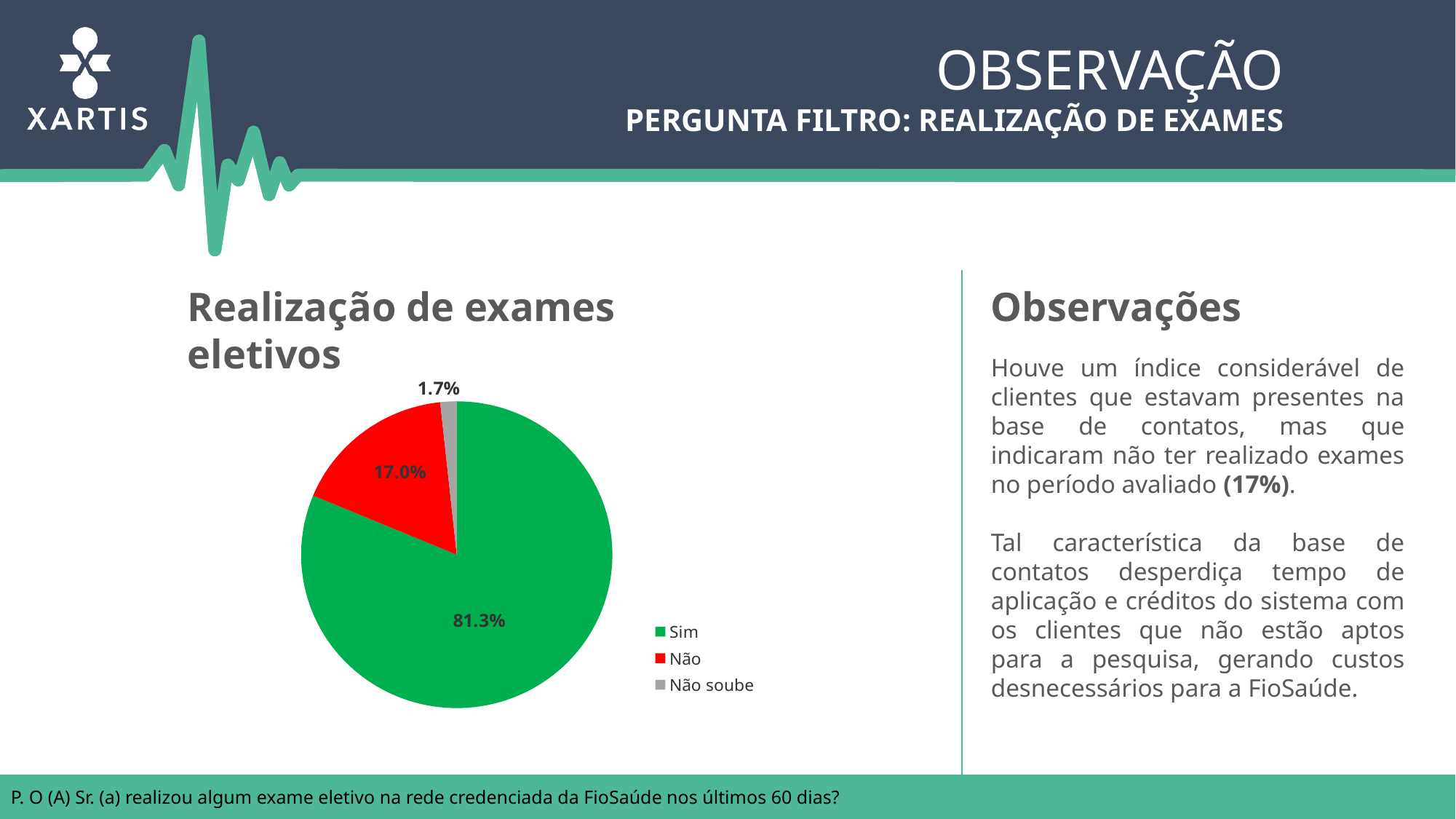
How many categories does the pie chart have? 3 What is the difference in percentage points between "Sim" and "Não"? 64.3 What colour is the slice for "Não"? red Which category has the smallest share of the pie? Não soube Which category has the largest share of the pie? Sim Which is larger, the share for "Não" or the share for "Não soube"? Não What is the title of the chart? Realização de exames eletivos What percentage of the pie corresponds to "Sim"? 81.3% How many entries does the legend list? 3 What percentage of the pie corresponds to "Não soube"? 1.7% What percentage of the pie corresponds to "Não"? 17.0% What type of chart is shown on the slide? pie chart